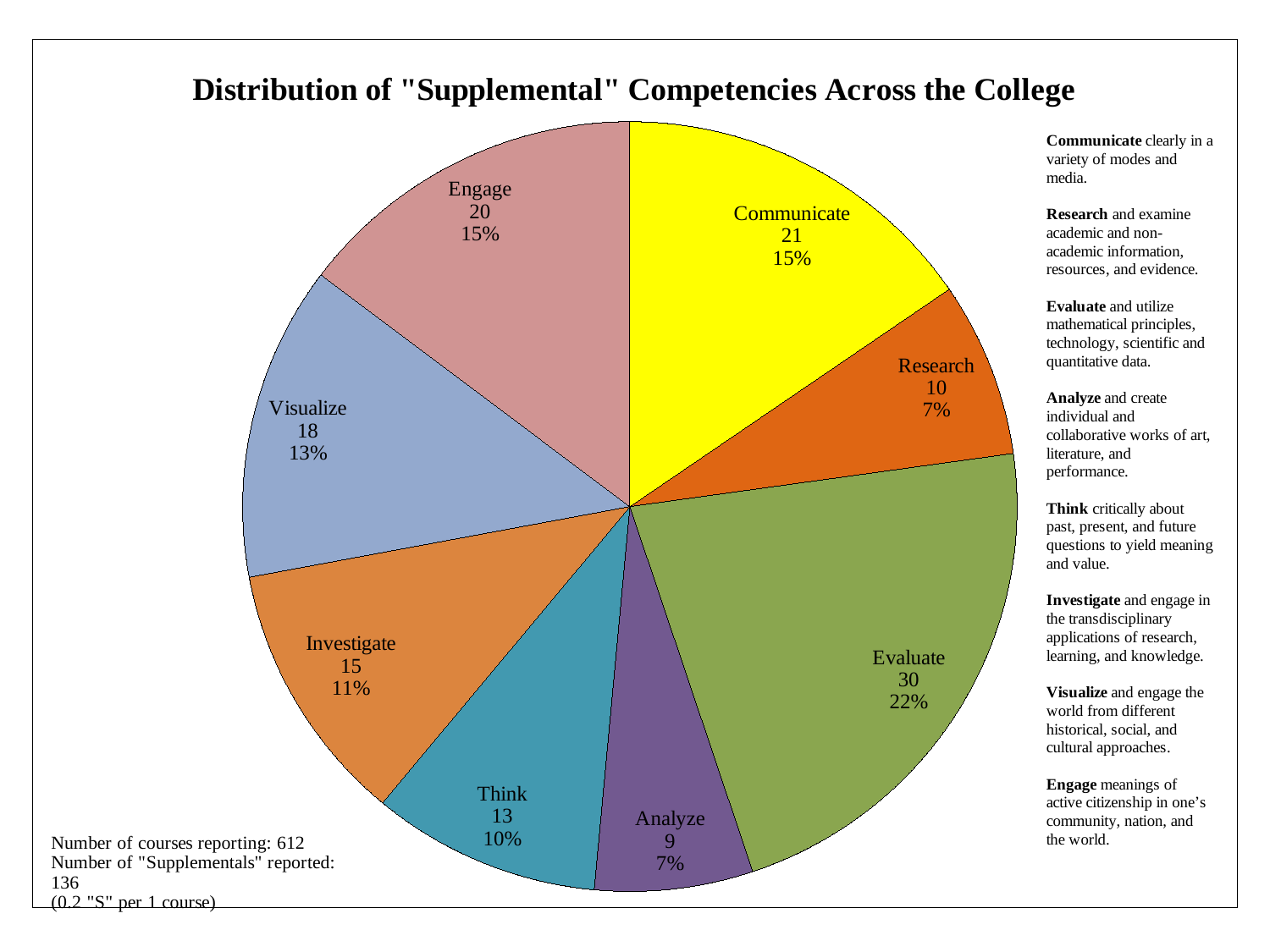
Which is larger, the value for Engage or the value for Investigate? Engage What percentage share does the Visualize slice have? 13% How many slices does the pie chart have? 8 What type of chart is shown on the slide? pie chart Which competency has the largest slice? Evaluate What colour is the Evaluate slice? green What is the title of the chart? Distribution of "Supplemental" Competencies Across the College What is the value shown for the Communicate slice? 21 What percentage share does the Think slice have? 10% What is the difference between the values for Evaluate and Research? 20 Which competency has the smallest slice? Analyze What is the value shown for the Evaluate slice? 30